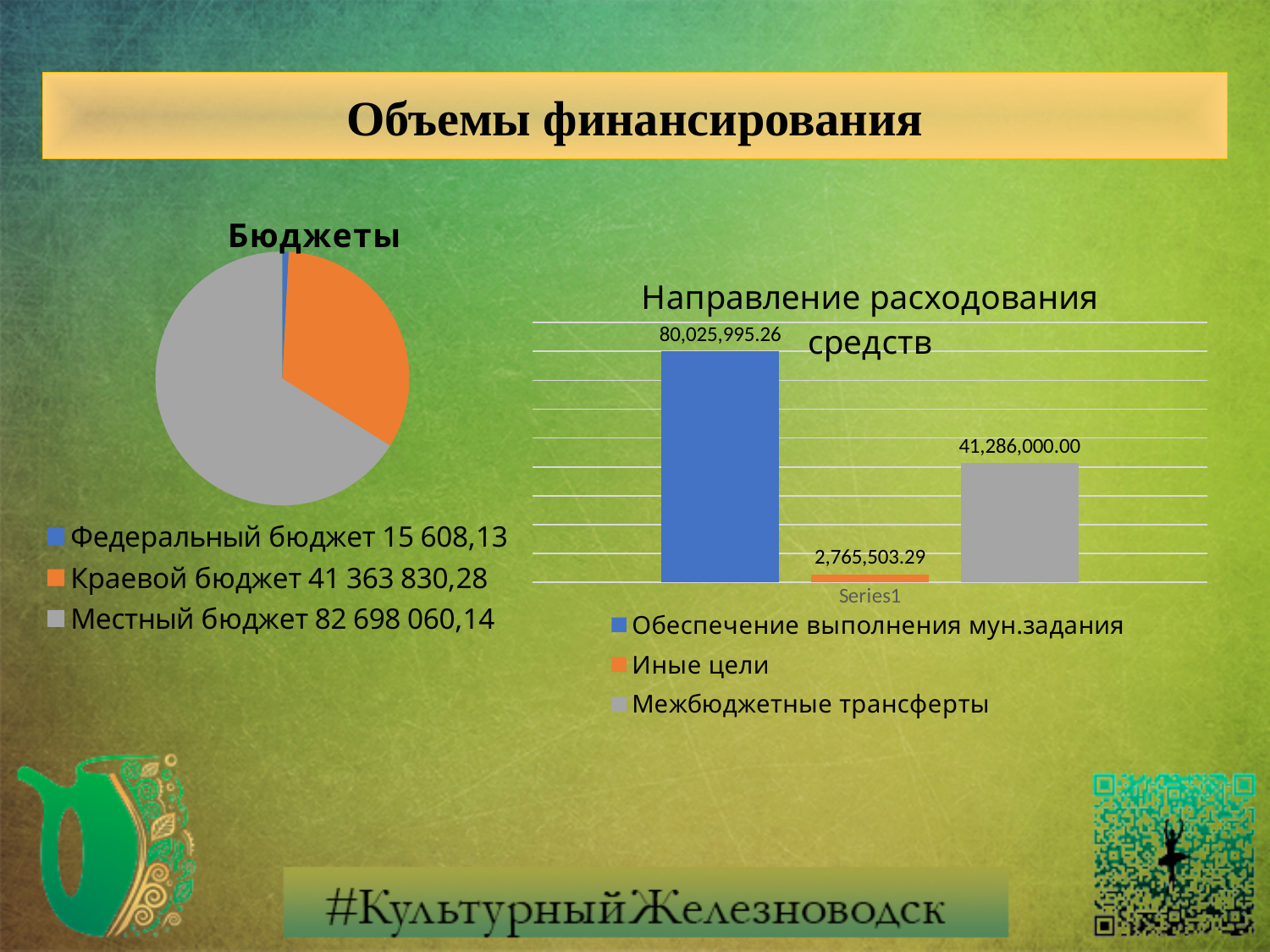
On the bar chart 'Направление расходования средств', what is the value for 'Обеспечение выполнения мун.задания'? 80,025,995.26 On the pie chart 'Бюджеты', what is the value for 'Краевой бюджет'? 41 363 830,28 What kind of chart is 'Направление расходования средств'? Bar chart On the bar chart 'Направление расходования средств', which category has the lowest value? Иные цели On the bar chart 'Направление расходования средств', how many bars are plotted? 3 On the pie chart 'Бюджеты', which is larger: 'Федеральный бюджет' or 'Краевой бюджет'? Краевой бюджет On the bar chart 'Направление расходования средств', what is the value for 'Иные цели'? 2,765,503.29 On the bar chart 'Направление расходования средств', what is the value for 'Межбюджетные трансферты'? 41,286,000.00 On the bar chart 'Направление расходования средств', which category has the highest value? Обеспечение выполнения мун.задания On the pie chart 'Бюджеты', how many entries does the legend list? 3 On the bar chart 'Направление расходования средств', what is the difference between 'Обеспечение выполнения мун.задания' and 'Межбюджетные трансферты'? 38,739,995.26 On the pie chart 'Бюджеты', which budget has the largest slice? Местный бюджет